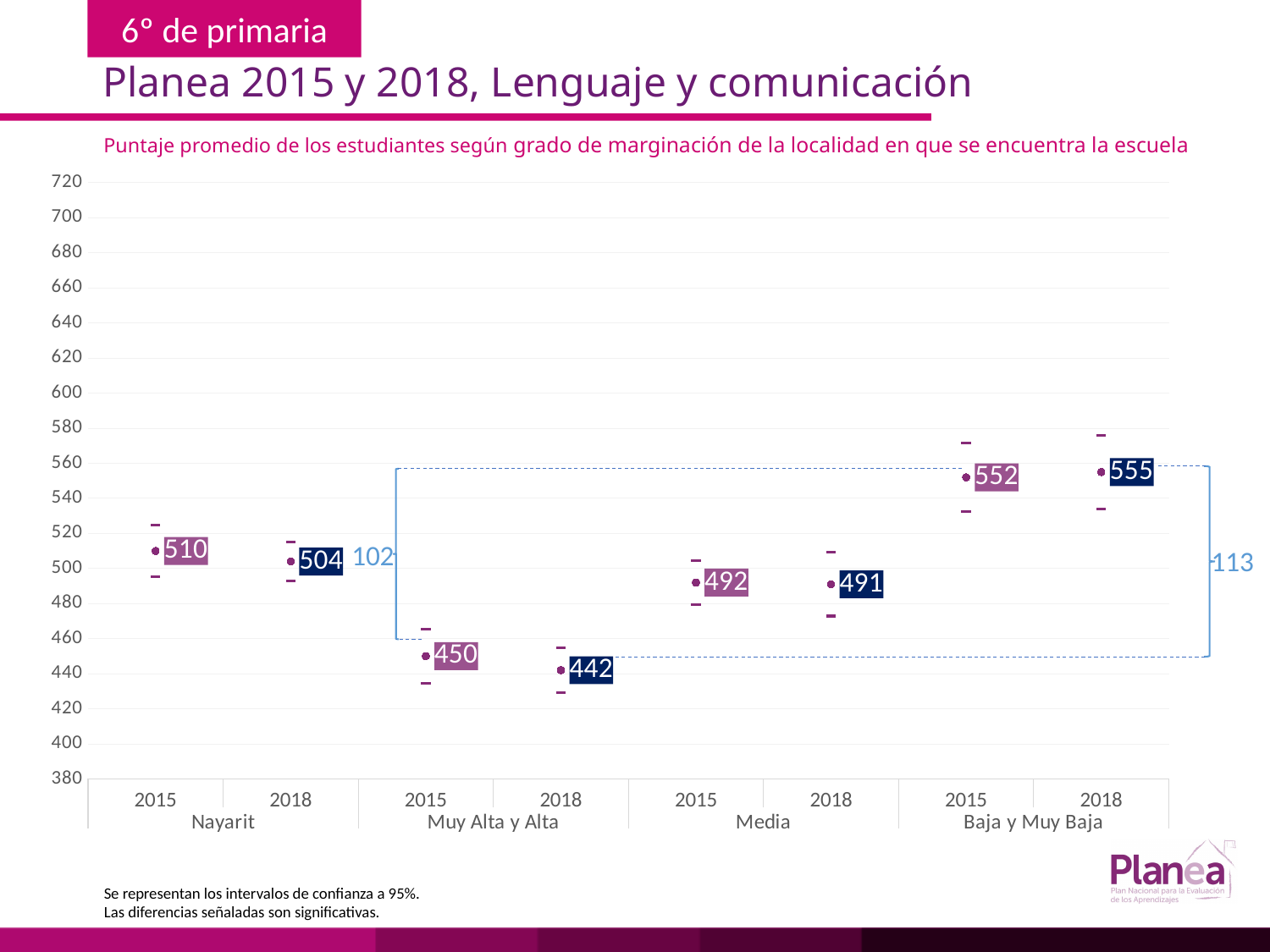
What is the average score for the Baja y Muy Baja group in 2018? 555 What is the difference between the 2015 scores of Baja y Muy Baja and Muy Alta y Alta? 102 What confidence level do the intervals shown in the chart represent? 95% Which group and year has the lowest average score? Muy Alta y Alta, 2018 (442) Did the score for Baja y Muy Baja rise or fall from 2015 to 2018? rise By how much did the Nayarit score change from 2015 to 2018? 6 points lower (510 to 504) Which group and year has the highest average score? Baja y Muy Baja, 2018 (555) How many marginación groups are shown on the x axis? 4 What is the average score for the Muy Alta y Alta group in 2018? 442 What is the average score for Nayarit in 2015? 510 For the Media group, which year has the higher score, 2015 or 2018? 2015 Is the 2015 value for Muy Alta y Alta greater or less than 460? less